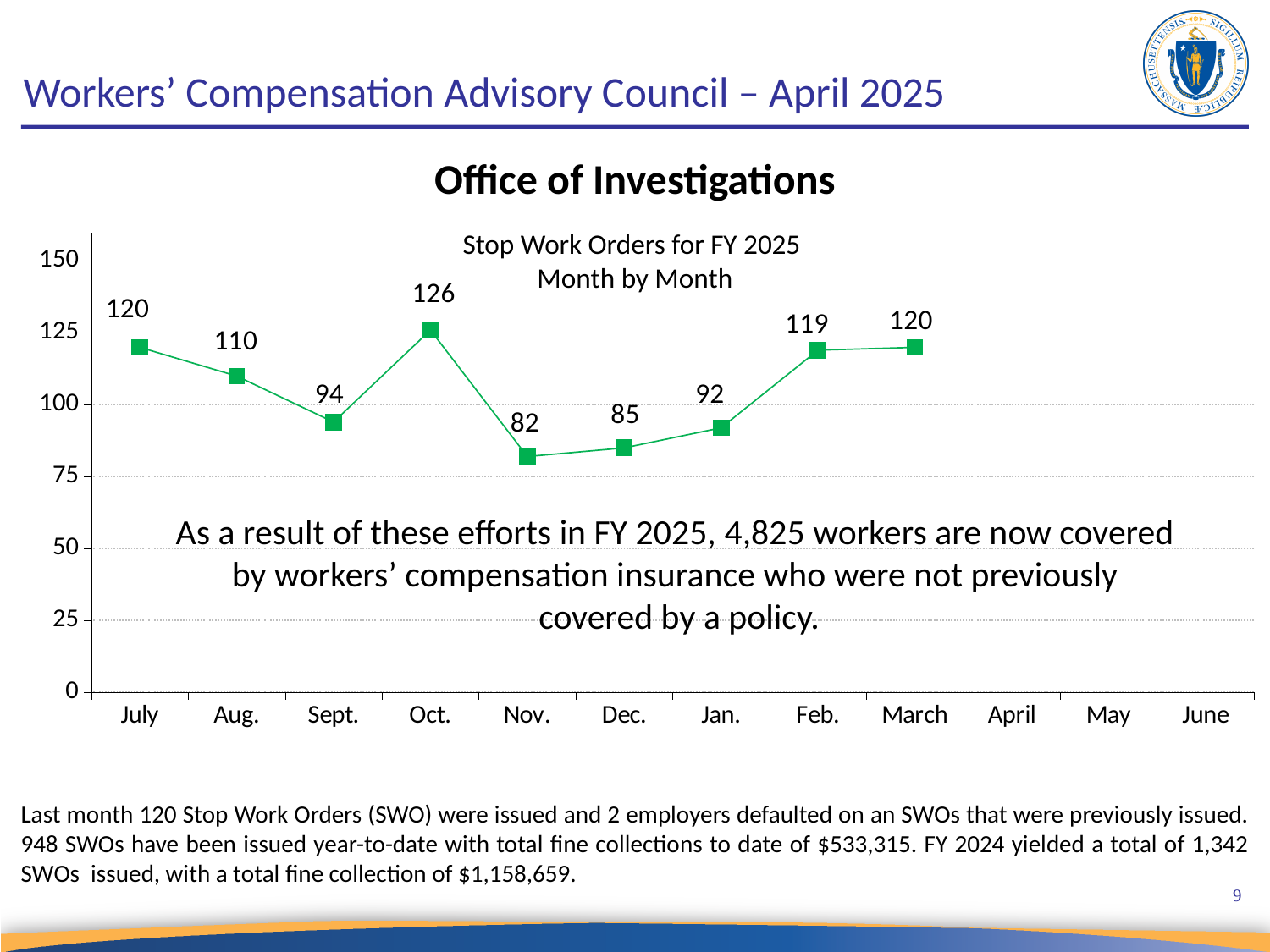
Which month has the lowest number of Stop Work Orders? Nov. What is the title of the chart? Stop Work Orders for FY 2025 Month by Month What is the value for October? 126 Which month has the highest number of Stop Work Orders? Oct. What is the difference between the values for October and November? 44 Which is larger, the value for August or the value for January? Aug. What is the value for November? 82 Is the value for September greater or less than 100? less What kind of chart is this? line chart How many months have a plotted data point? 9 Do the values rise or fall from November to February? rise What is the value for February? 119